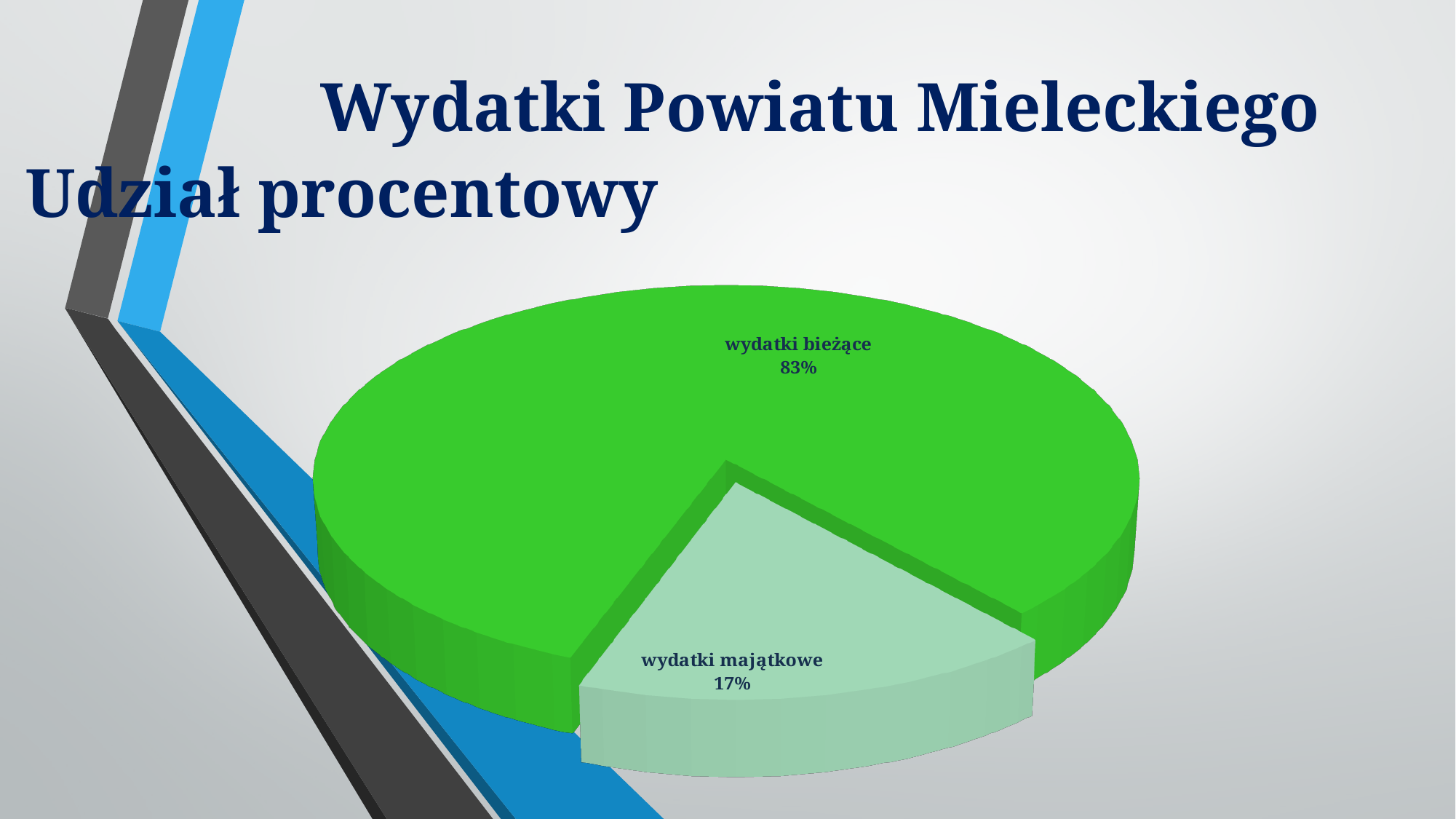
What share of the pie does "wydatki majątkowe" represent? 17% Is the share for "wydatki bieżące" greater or less than 80%? greater Which slice is pulled out (exploded) from the pie? wydatki majątkowe Is the share for "wydatki majątkowe" greater or less than 20%? less Which slice of the pie is the smallest? wydatki majątkowe What share of the pie does "wydatki bieżące" represent? 83% Which slice of the pie is the largest? wydatki bieżące What is the difference in percentage points between "wydatki bieżące" and "wydatki majątkowe"? 66 percentage points Which is larger, "wydatki bieżące" or "wydatki majątkowe"? wydatki bieżące What is the title shown on the slide above the chart? Wydatki Powiatu Mieleckiego Udział procentowy How many slices does the pie chart have? 2 What kind of chart is shown on the slide? Pie chart